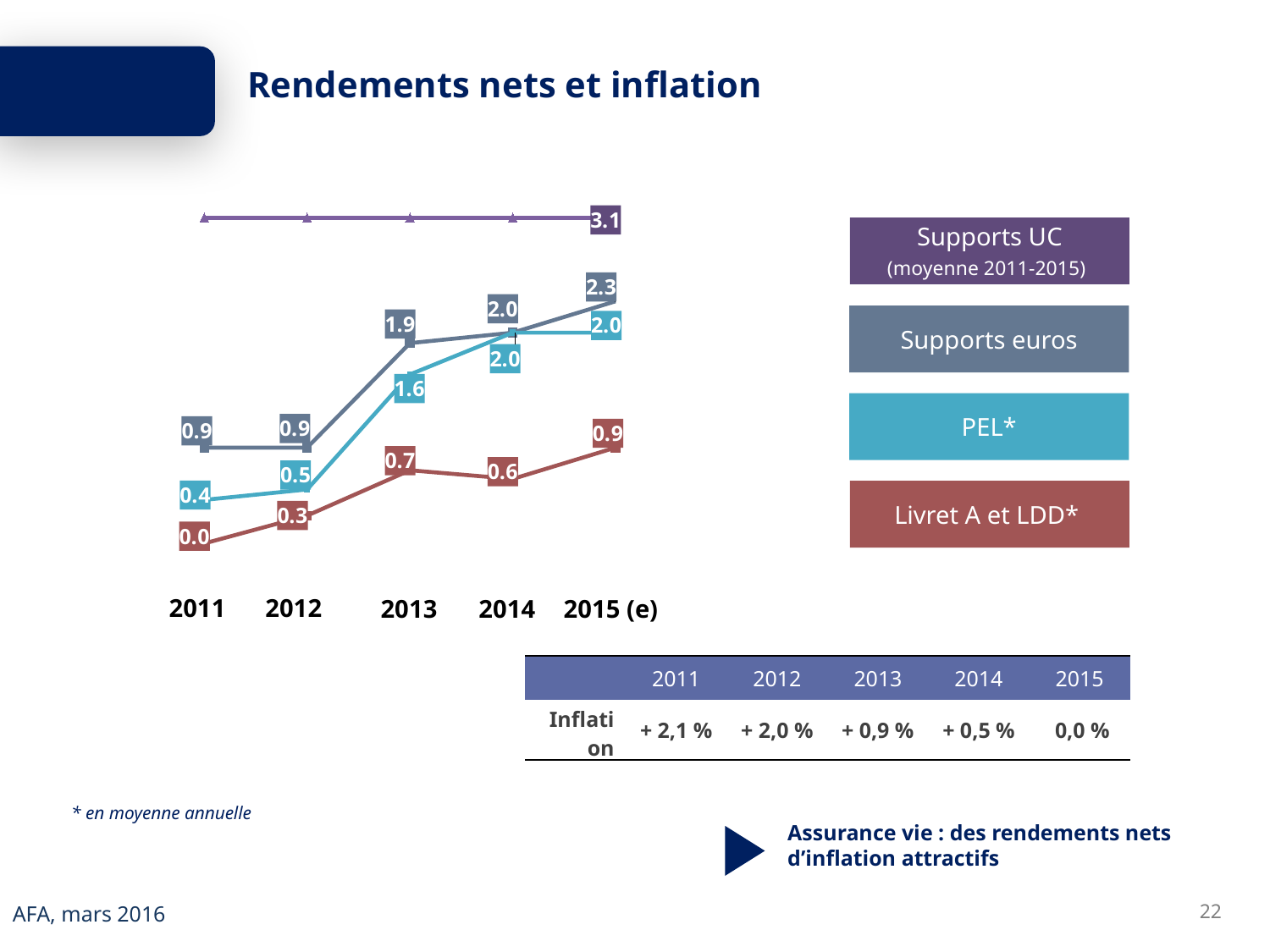
Does the value for PEL* rise or fall from 2011 to 2014? rise In which year is the value for Livret A et LDD* lowest? 2011 In which year is the value for Supports euros highest? 2015 (e) What is the difference between the Supports euros value and the PEL* value in 2013? 0.3 What is the value for Livret A et LDD* in 2014? 0.6 How many years are shown on the x axis of the chart? 5 How many series does the legend list? 4 What type of chart is shown on the slide? line chart What is the value shown for Supports UC (moyenne 2011-2015)? 3.1 What is the value for Supports euros in 2013? 1.9 What is the value for PEL* in 2011? 0.4 Which is larger in 2015 (e): the value for Supports euros or the value for PEL*? Supports euros